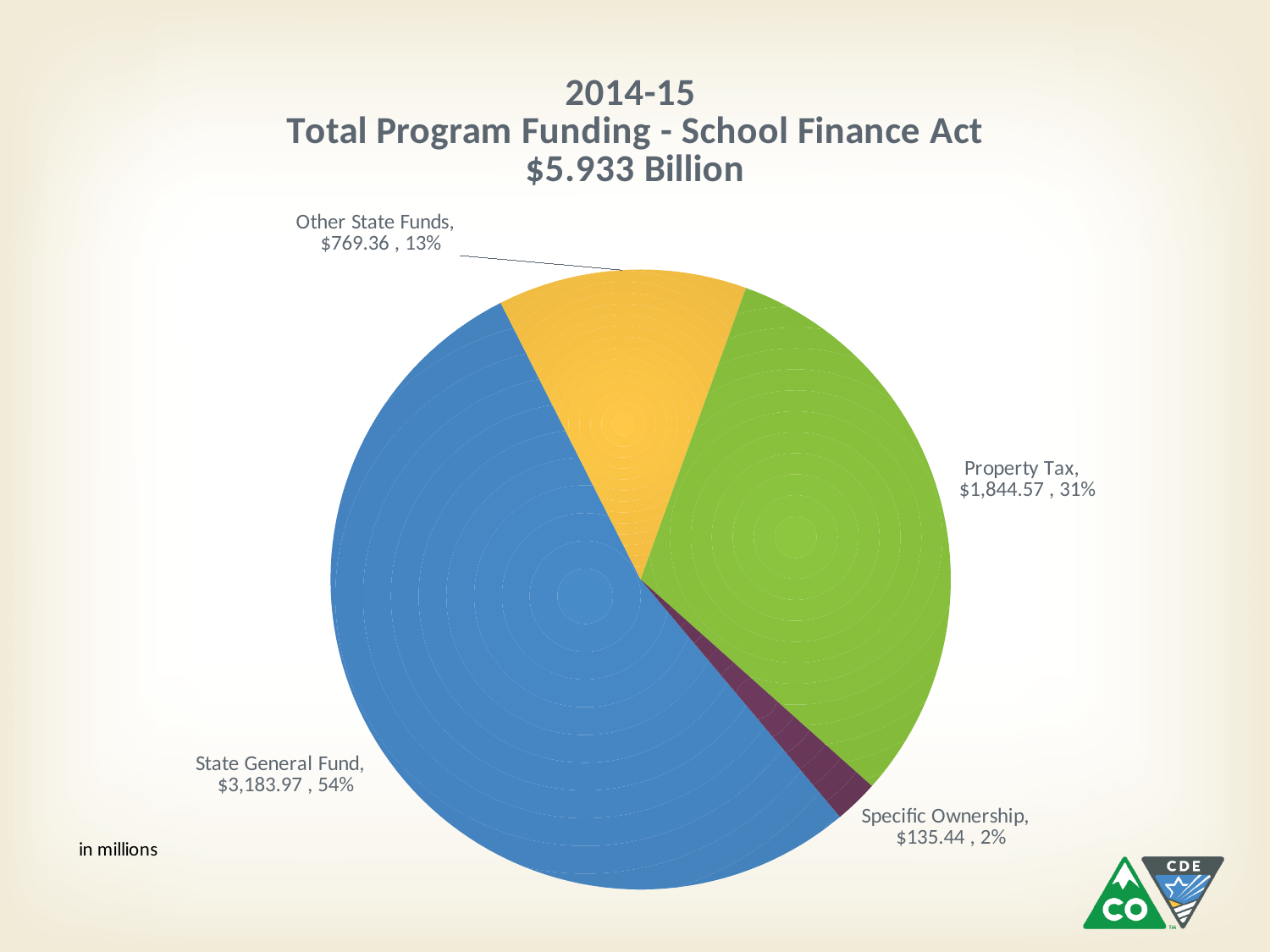
What percentage share of the pie does Other State Funds represent? 13% What total funding amount is stated in the chart title? $5.933 Billion What is the value for Specific Ownership? $135.44 What kind of chart is shown on the slide? Pie chart What is the value for Property Tax? $1,844.57 What is the value for State General Fund? $3,183.97 Which category has the smallest slice of the pie? Specific Ownership Which is larger, Other State Funds or Specific Ownership? Other State Funds What percentage share of the pie does Property Tax represent? 31% Which category has the largest slice of the pie? State General Fund How many slices does the pie chart have? 4 What is the difference between the State General Fund value and the Property Tax value? $1,339.40